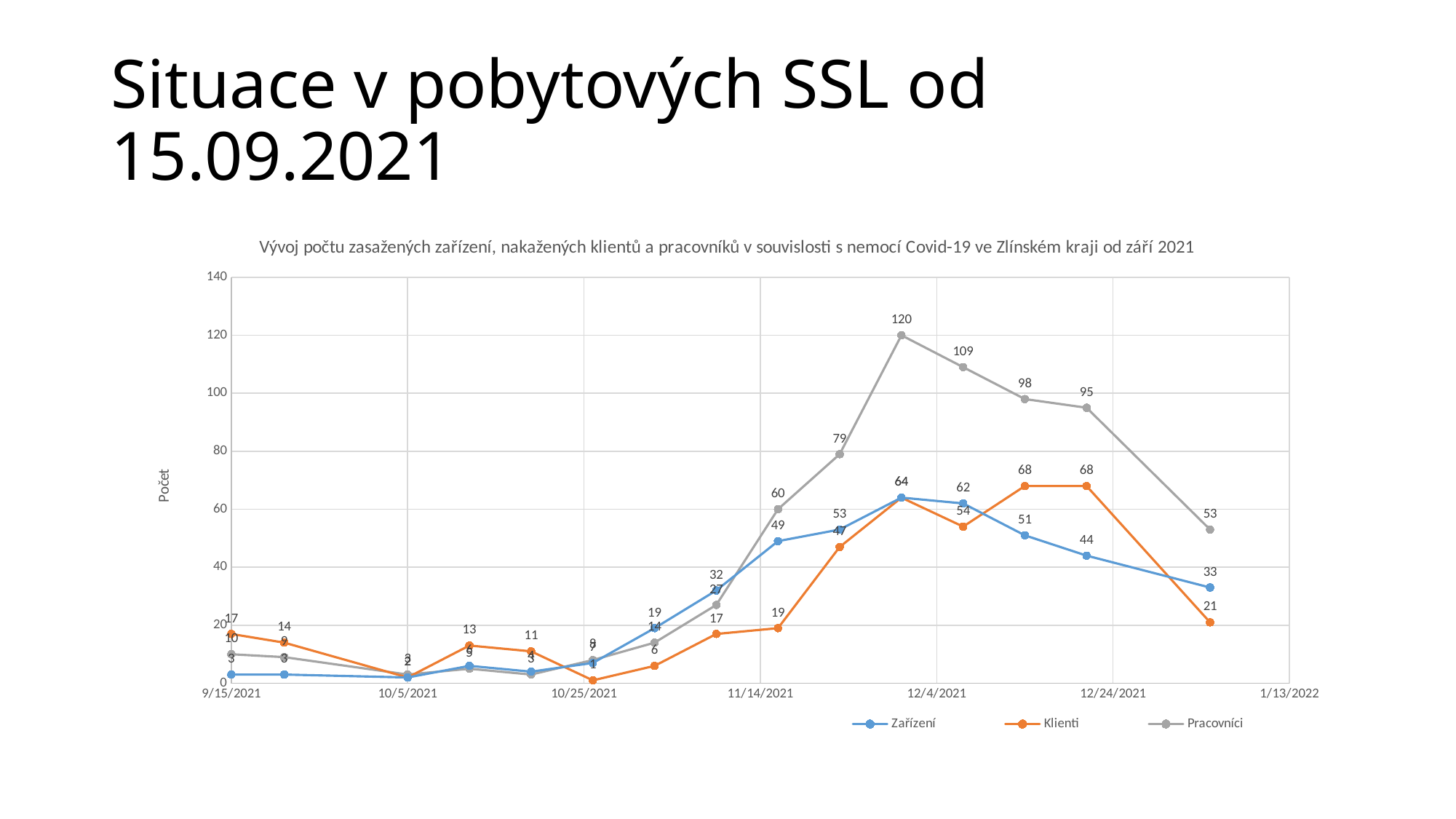
Which series reaches a higher peak value, Pracovníci or Klienti? Pracovníci What is the highest value reached by the Klienti series? 68 What is the highest value reached by the Zařízení series? 64 After reaching its peak of 120, does the Pracovníci line rise or fall toward the end of the chart? fall What is the highest value reached by the Pracovníci series? 120 How many series does the legend list? 3 What kind of chart is shown on the slide? line chart What is the last plotted value of the Klienti series? 21 What is the difference between the peak value of Pracovníci (120) and the peak value of Zařízení (64)? 56 What is the difference between the last plotted values of Pracovníci (53) and Klienti (21)? 32 What is the title of the vertical axis? Počet Is the peak value of the Pracovníci series greater or less than 100? greater